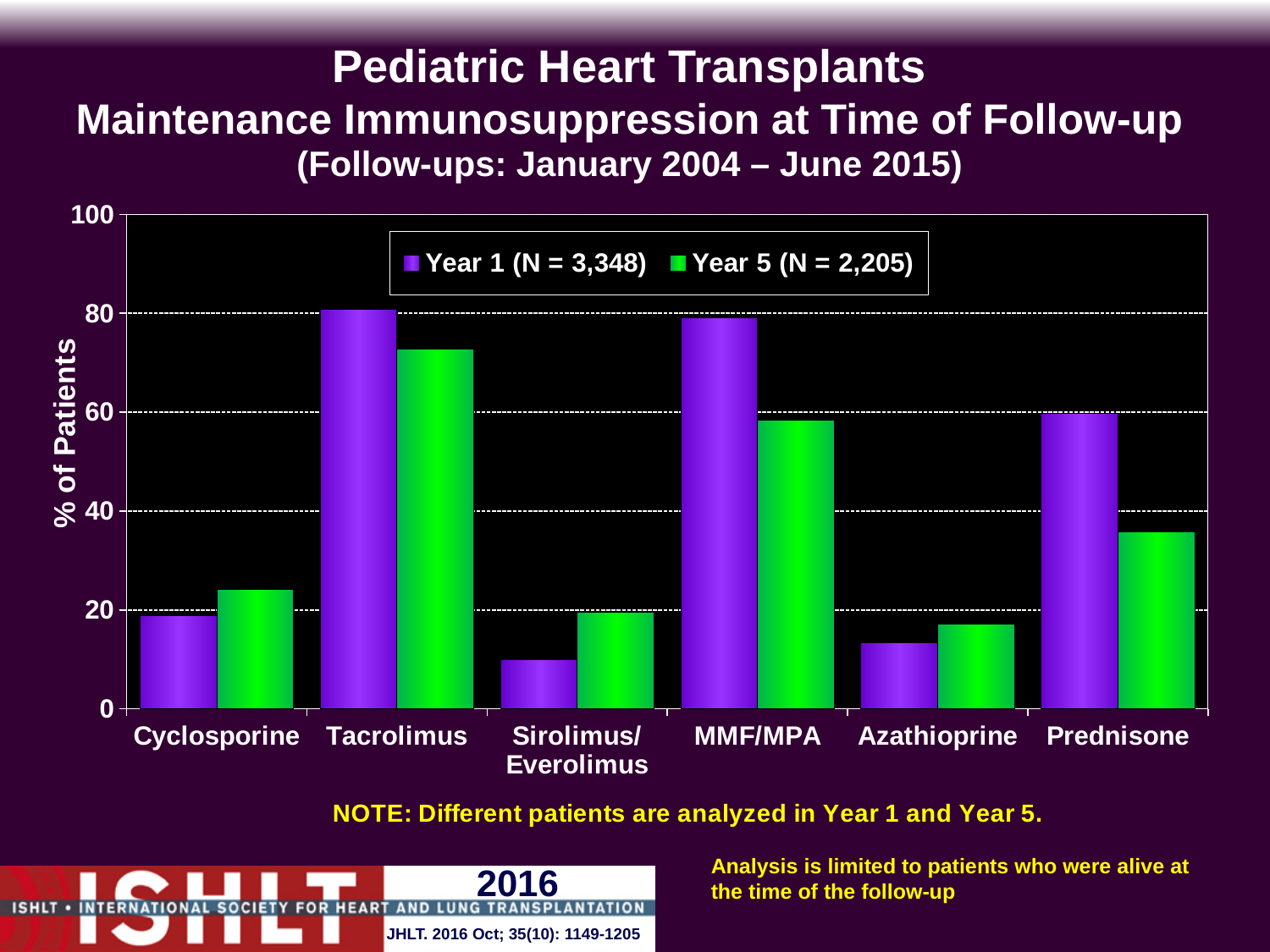
How many drug categories are shown on the x axis? 6 Is the Year 5 value for Tacrolimus greater or less than 60? greater How many series does the legend list? 2 What is the label on the y axis? % of Patients Is the Year 5 value for Prednisone greater or less than 40? less What is the N given in the legend for Year 1? 3,348 For Cyclosporine, which is larger: the Year 1 value or the Year 5 value? Year 5 What kind of chart is shown on the slide? bar chart Which drug has the lowest Year 1 percentage of patients? Sirolimus/Everolimus Which drug has the highest Year 5 percentage of patients? Tacrolimus Is the Year 1 value for Sirolimus/Everolimus greater or less than 20? less For Prednisone, which is larger: the Year 1 value or the Year 5 value? Year 1